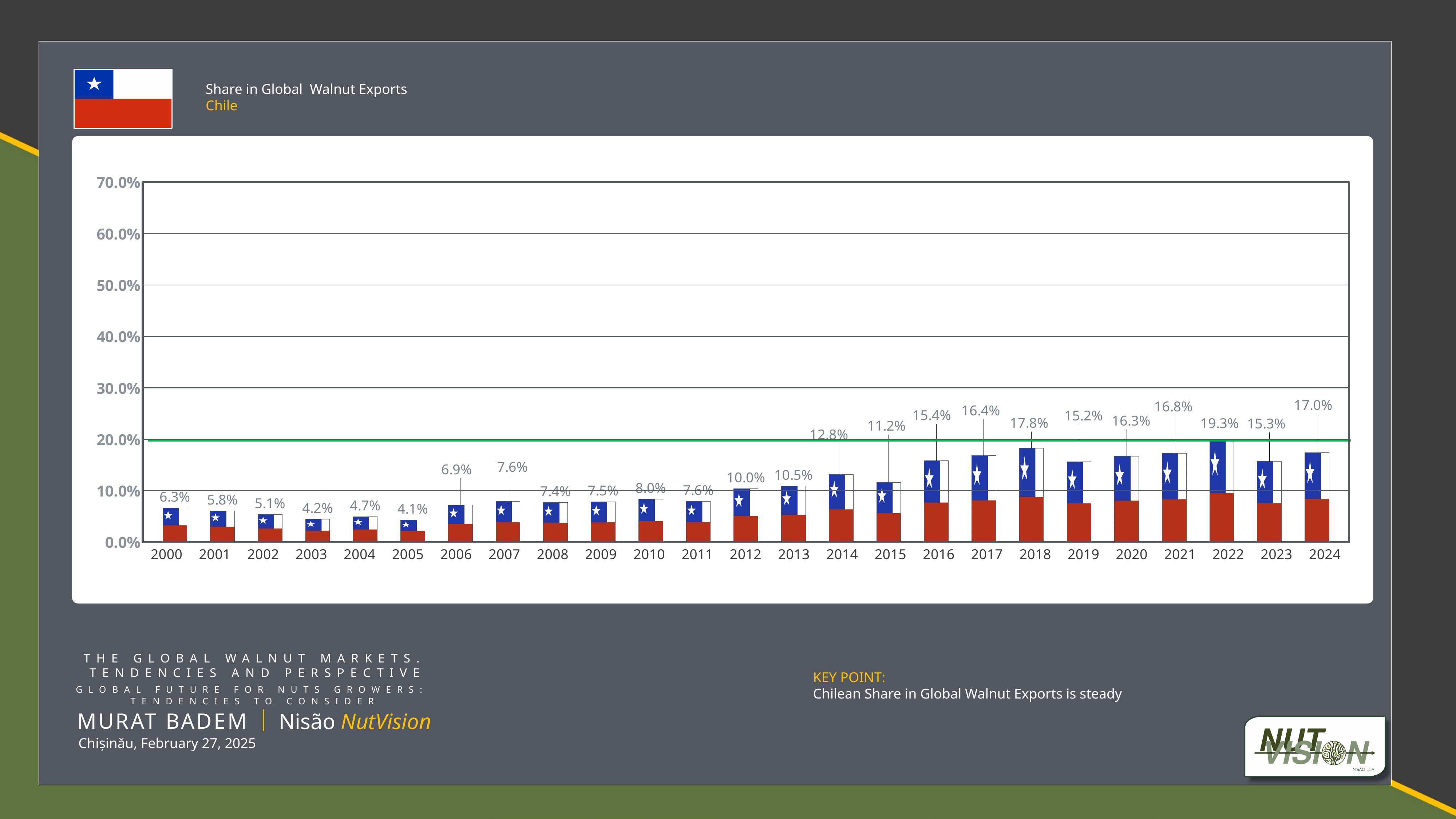
Which year has the lowest share in global walnut exports? 2005 What is Chile's share in global walnut exports in 2024? 17.0% Do the values generally rise or fall from 2005 to 2018? rise What is Chile's share in global walnut exports in 2000? 6.3% What is the difference between the 2022 share and the 2023 share? 4.0% Which year has the highest share in global walnut exports? 2022 How many years are shown on the x axis? 25 Which year has a larger share, 2018 or 2021? 2018 Is the value for 2022 greater or less than 20.0%? less What kind of chart is shown on the slide? bar chart Which country does the chart show the share in global walnut exports for? Chile What is Chile's share in global walnut exports in 2022? 19.3%